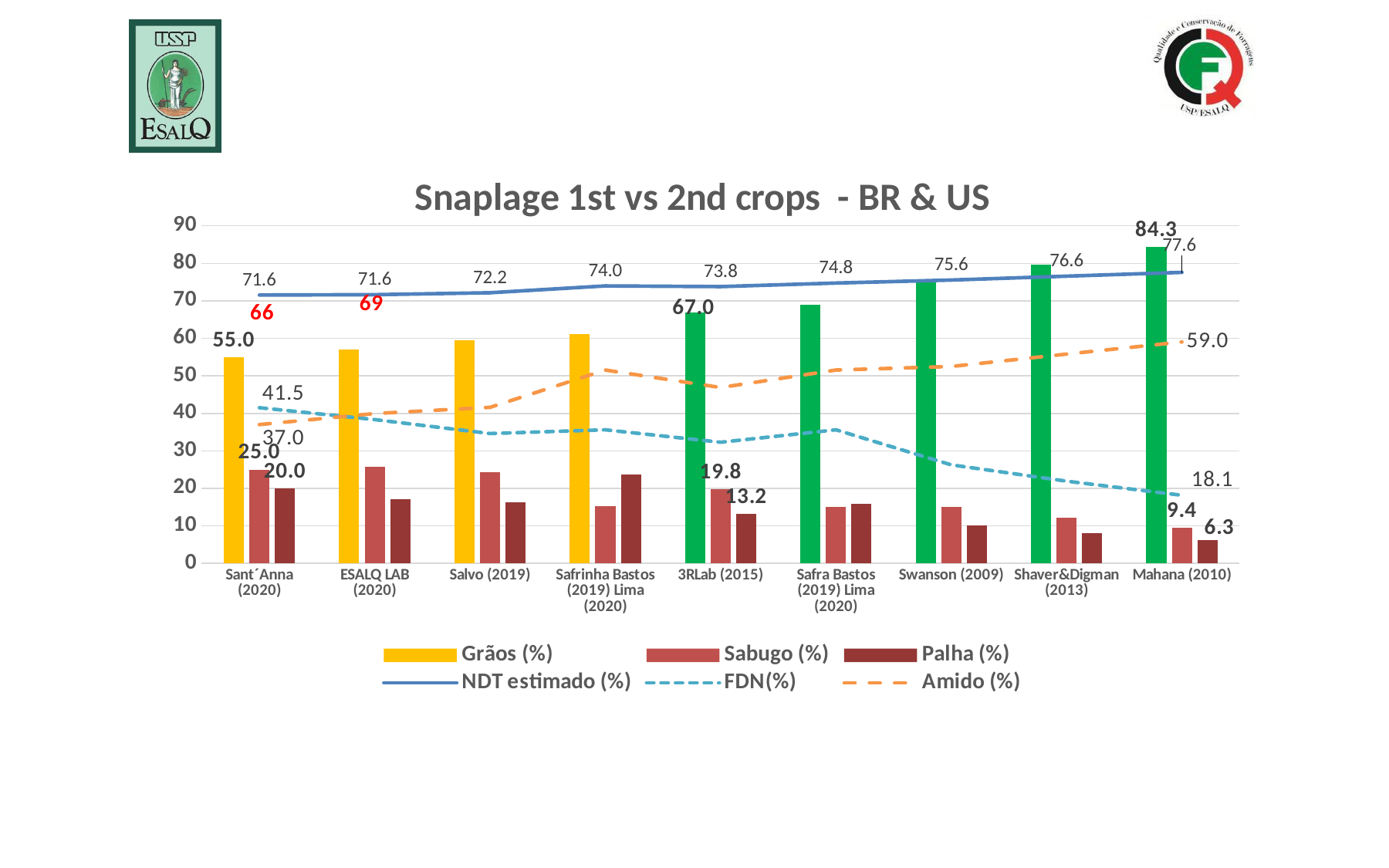
Which category has the lowest Palha (%) value? Mahana (2010) How many series does the legend list? 6 Which category has the highest NDT estimado (%) value? Mahana (2010) How many categories are shown on the x axis? 9 What is the Grãos (%) value for Mahana (2010)? 84.3 What is the NDT estimado (%) value for Swanson (2009)? 75.6 What is the FDN(%) value for Mahana (2010)? 18.1 Does the NDT estimado (%) line rise or fall from left to right across the categories? rise Is the Grãos (%) value for Salvo (2019) greater or less than 50? greater Which is larger, the Sabugo (%) value for Sant´Anna (2020) or for 3RLab (2015)? Sant´Anna (2020) What is the Amido (%) value for Sant´Anna (2020)? 37.0 What is the difference between the Grãos (%) value for Mahana (2010) and for Sant´Anna (2020)? 29.3